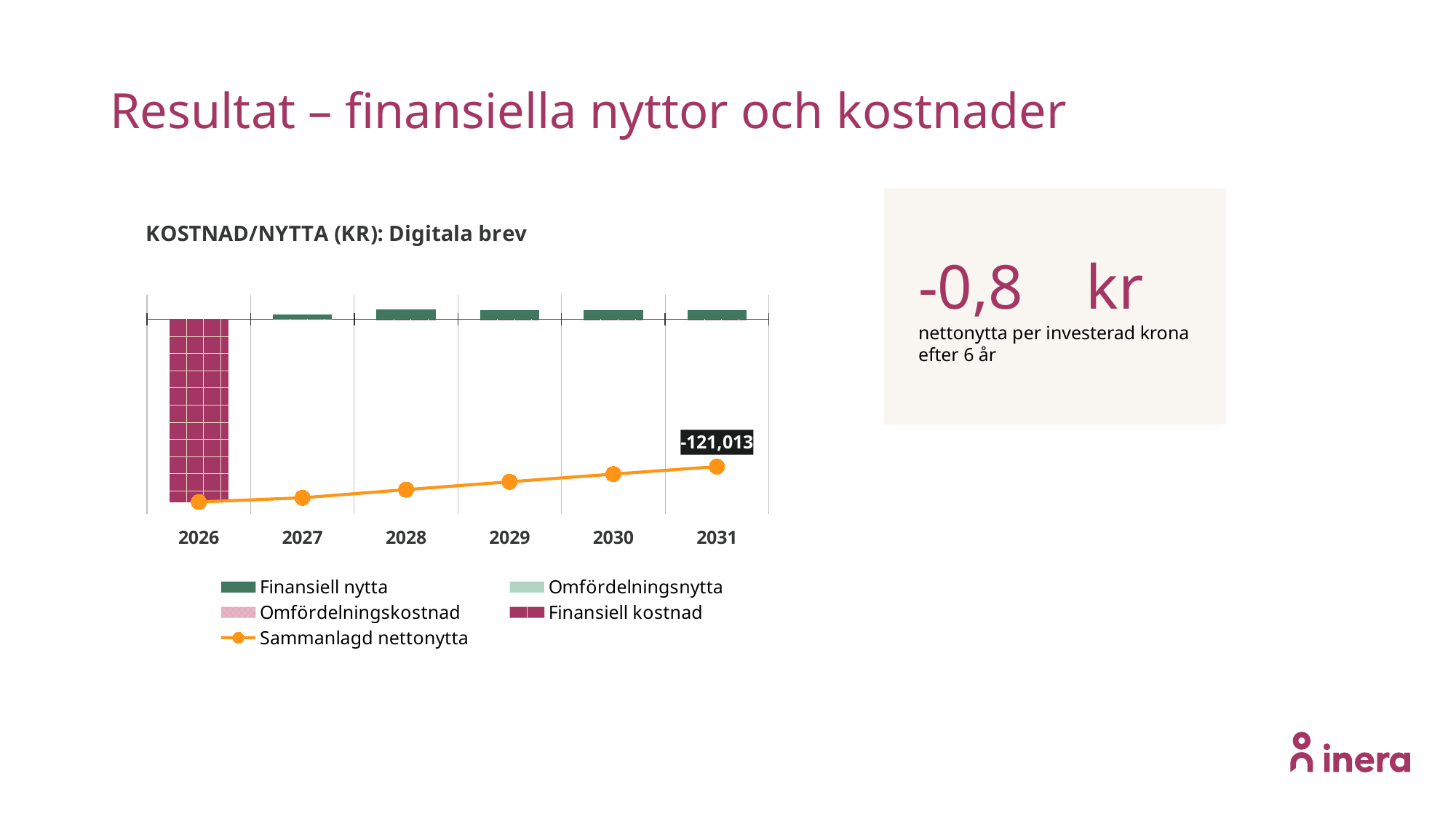
What kind of chart is shown on the slide? Combined bar and line chart Which year has a larger Finansiell kostnad bar, 2026 or 2027? 2026 In which year is Sammanlagd nettonytta lowest? 2026 How many years are shown on the x axis of the chart? 6 What colour is the Sammanlagd nettonytta line in the chart? Orange Which year has a higher Sammanlagd nettonytta, 2028 or 2030? 2030 In which year is Sammanlagd nettonytta highest? 2031 What is the value of Sammanlagd nettonytta in 2031? -121,013 Does the Sammanlagd nettonytta line rise or fall from 2026 to 2031? Rises How many series does the chart's legend list? 5 What is the title of the chart? KOSTNAD/NYTTA (KR): Digitala brev In which year is the Finansiell kostnad bar largest? 2026